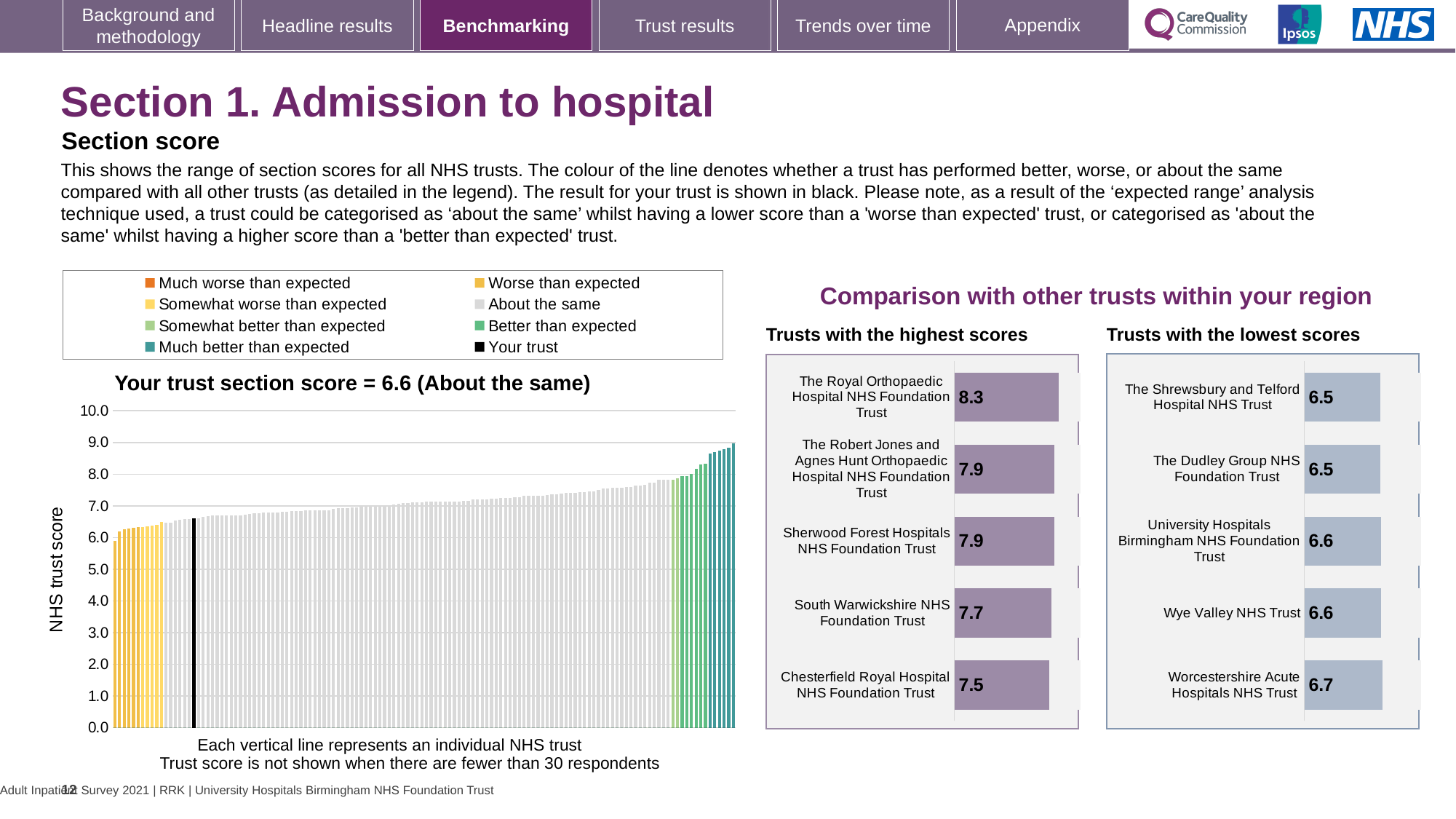
How many trusts are listed in the 'Trusts with the highest scores' chart? 5 In the 'Trusts with the lowest scores' chart, what is the score for Wye Valley NHS Trust? 6.6 In the chart titled 'Your trust section score = 6.6 (About the same)', what kind of chart is shown? bar chart In the chart titled 'Your trust section score = 6.6 (About the same)', what is the label on the vertical axis? NHS trust score How many entries does the legend above the 'Your trust section score' chart list? 8 In the 'Trusts with the highest scores' chart, which trust has the lowest score? Chesterfield Royal Hospital NHS Foundation Trust In the 'Trusts with the lowest scores' chart, what is the difference between the scores of Worcestershire Acute Hospitals NHS Trust and The Dudley Group NHS Foundation Trust? 0.2 In the 'Trusts with the lowest scores' chart, which trust has the highest score? Worcestershire Acute Hospitals NHS Trust In the chart titled 'Your trust section score = 6.6 (About the same)', what is the section score for your trust? 6.6 In the chart titled 'Your trust section score = 6.6 (About the same)', is the value of the tallest bar greater or less than 8.0? greater In the 'Trusts with the highest scores' chart, what is the difference between the scores of The Royal Orthopaedic Hospital NHS Foundation Trust and Chesterfield Royal Hospital NHS Foundation Trust? 0.8 In the 'Trusts with the highest scores' chart, what is the score for The Royal Orthopaedic Hospital NHS Foundation Trust? 8.3